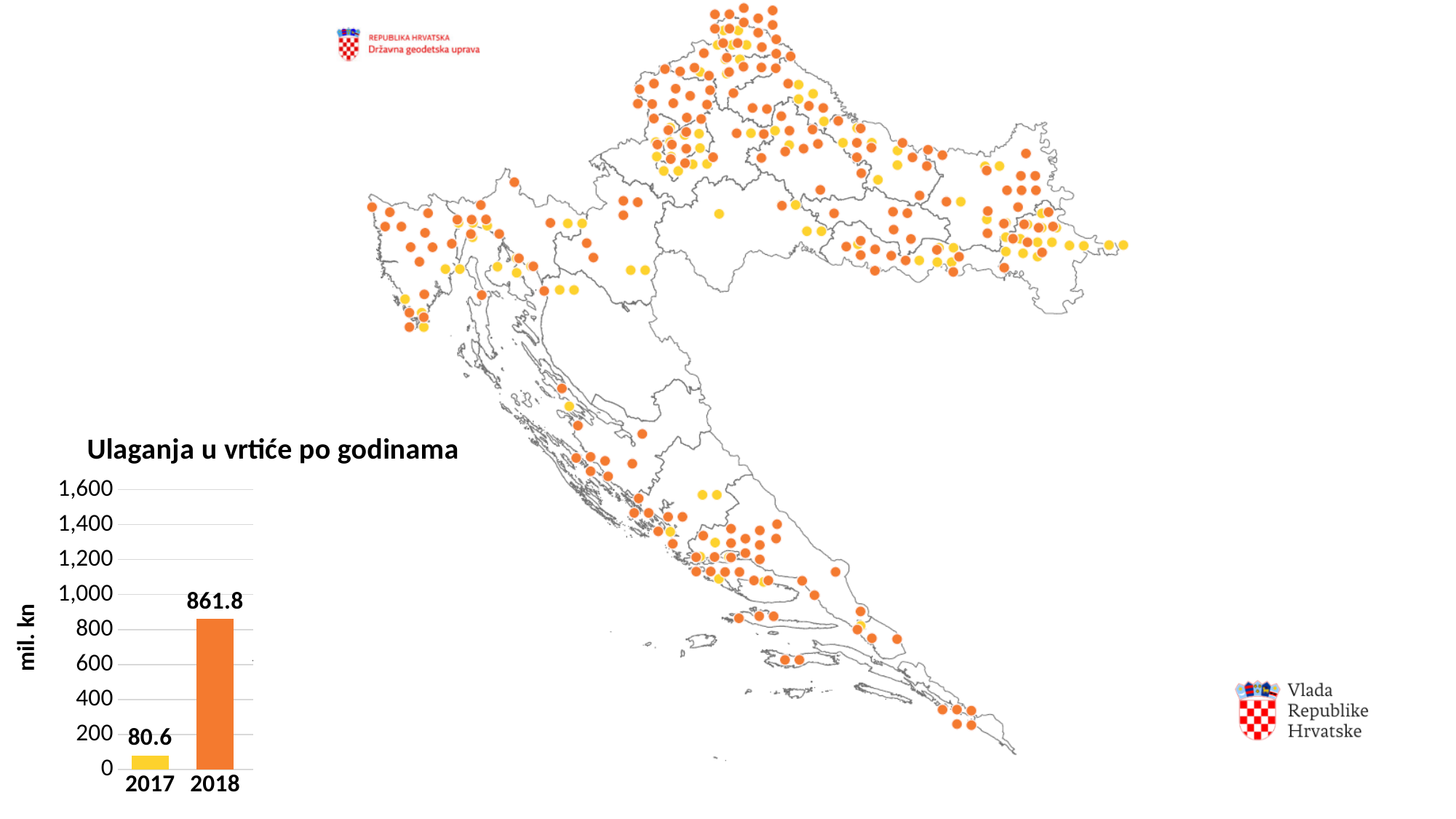
What is the value for 2017 in the 'Ulaganja u vrtiće po godinama' chart? 80.6 What is the value for 2018 in the 'Ulaganja u vrtiće po godinama' chart? 861.8 Which year has the highest value in the 'Ulaganja u vrtiće po godinama' chart? 2018 In the 'Ulaganja u vrtiće po godinama' chart, is the value for 2017 or 2018 larger? 2018 Which year has the lowest value in the 'Ulaganja u vrtiće po godinama' chart? 2017 What is the difference between the 2018 and 2017 values in the 'Ulaganja u vrtiće po godinama' chart? 781.2 What kind of chart is 'Ulaganja u vrtiće po godinama'? bar chart Do the values rise or fall from 2017 to 2018 in the 'Ulaganja u vrtiće po godinama' chart? rise Is the value for 2018 in the 'Ulaganja u vrtiće po godinama' chart greater or less than 1,000? less Is the value for 2017 in the 'Ulaganja u vrtiće po godinama' chart greater or less than 200? less How many years are shown in the 'Ulaganja u vrtiće po godinama' chart? 2 What is the y-axis label of the 'Ulaganja u vrtiće po godinama' chart? mil. kn